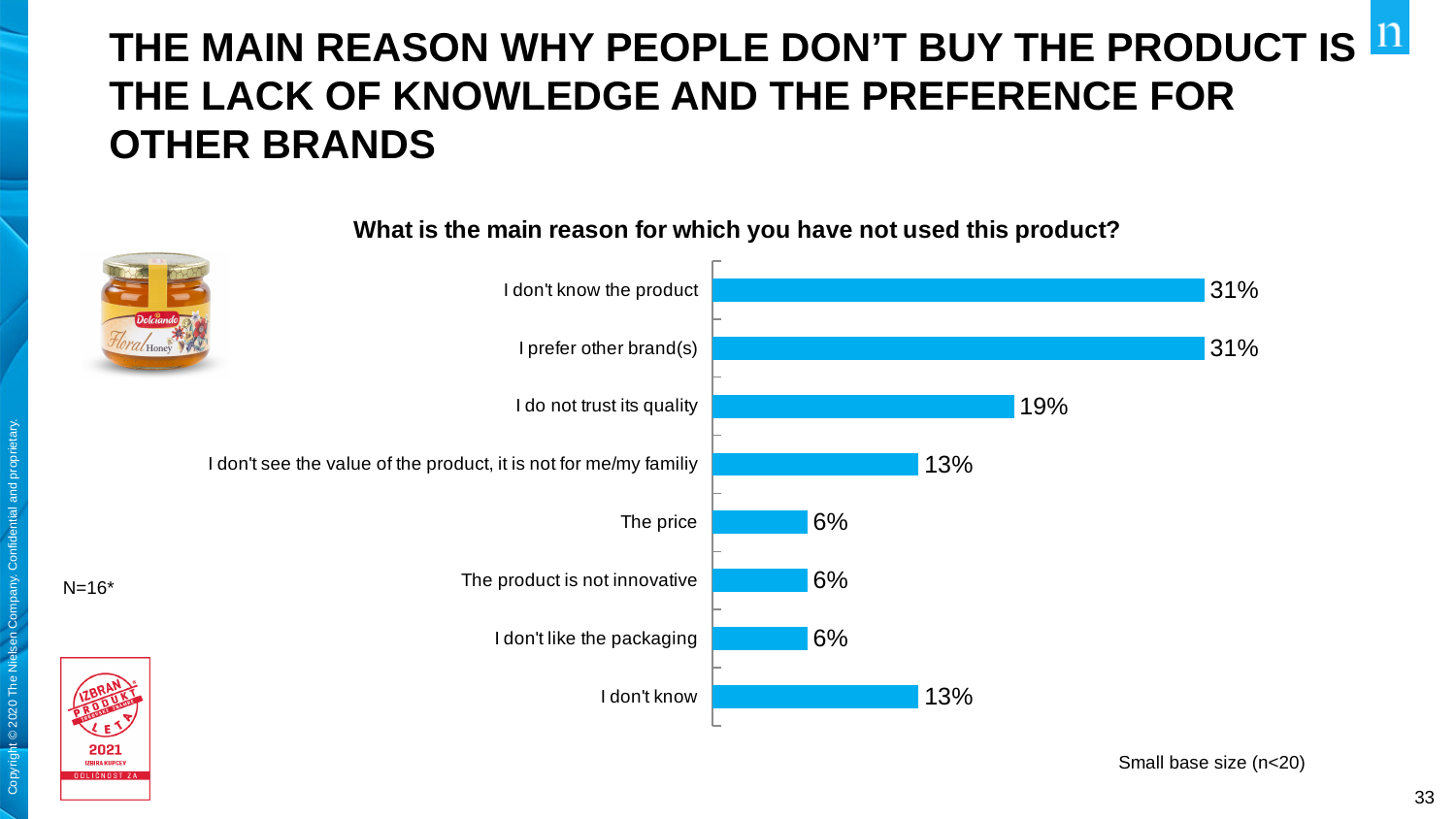
What is the sample size (N) noted next to the chart? N=16* What is the difference between "I prefer other brand(s)" and "I do not trust its quality"? 12% What is the value for "I do not trust its quality"? 19% What kind of chart is shown on the slide? Bar chart What is the value for "The price"? 6% What is the difference between "I don't know the product" and "I don't like the packaging"? 25% What question is the chart based on, as shown in its title? What is the main reason for which you have not used this product? How many reasons (categories) are shown in the chart? 8 Which is larger: the value for "I don't see the value of the product, it is not for me/my familiy" or the value for "The product is not innovative"? I don't see the value of the product, it is not for me/my familiy Which reason has the lowest value among "I do not trust its quality", "The price" and "I don't know"? The price What is the value for "I don't know"? 13% What percentage of respondents said "I don't know the product" as the main reason for not using it? 31%